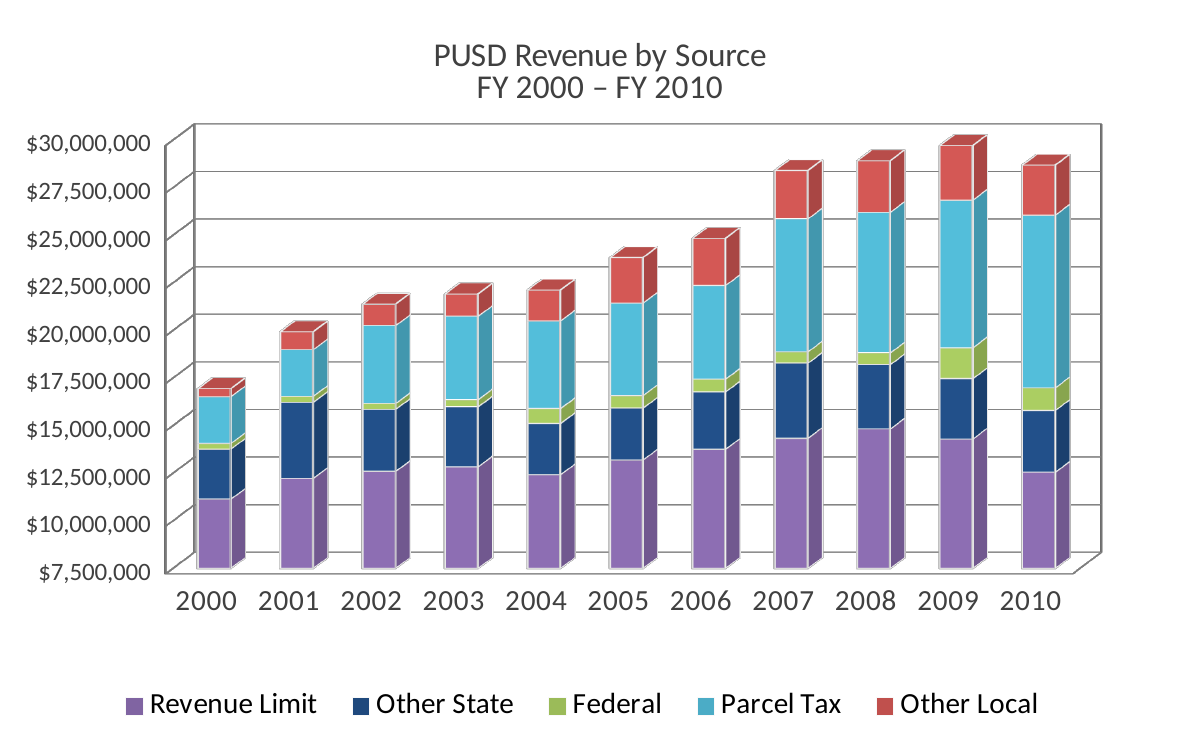
Is the total revenue for 2005 greater or less than $25,000,000? less How many revenue sources does the legend list? 5 Which year has the highest total revenue? 2009 Does total revenue generally rise or fall from 2000 to 2009? rise Is the total revenue for 2009 greater or less than $27,500,000? greater What kind of chart is shown on the slide? Stacked bar chart Which year has the lowest total revenue? 2000 Is the Revenue Limit value for 2000 greater or less than $12,500,000? less Which year has the larger total revenue, 2006 or 2007? 2007 What is the title of the chart? PUSD Revenue by Source FY 2000 – FY 2010 How many fiscal years are plotted along the x axis? 11